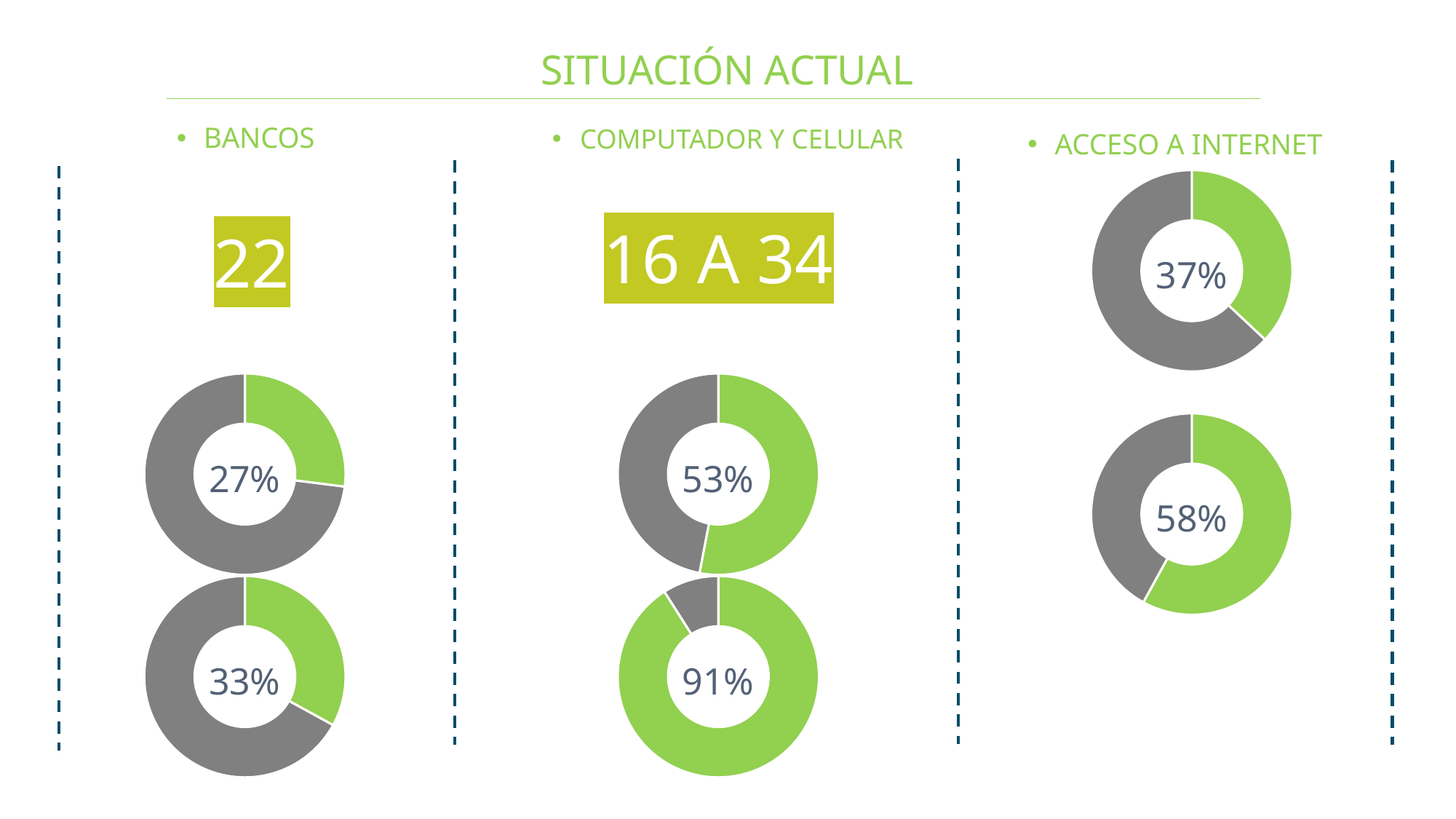
What percentage is shown in the centre of the lower donut chart in the ACCESO A INTERNET column? 58% What percentage is shown in the centre of the lower donut chart in the COMPUTADOR Y CELULAR column? 91% What percentage is shown in the centre of the upper donut chart in the COMPUTADOR Y CELULAR column? 53% Which of the six donut charts on the slide shows the highest percentage? The lower chart in the COMPUTADOR Y CELULAR column (91%) What is the difference between the percentages in the two donut charts of the COMPUTADOR Y CELULAR column? 38% How many donut charts are shown on the slide? 6 What percentage is shown in the centre of the upper donut chart in the ACCESO A INTERNET column? 37% What percentage is shown in the centre of the lower donut chart in the BANCOS column? 33% What percentage is shown in the centre of the upper donut chart in the BANCOS column? 27% Which of the six donut charts on the slide shows the lowest percentage? The upper chart in the BANCOS column (27%) Which is larger: the percentage in the lower BANCOS donut chart or the percentage in the upper ACCESO A INTERNET donut chart? The upper ACCESO A INTERNET chart (37%) What type of chart is used in each column of the slide? Donut (pie) chart